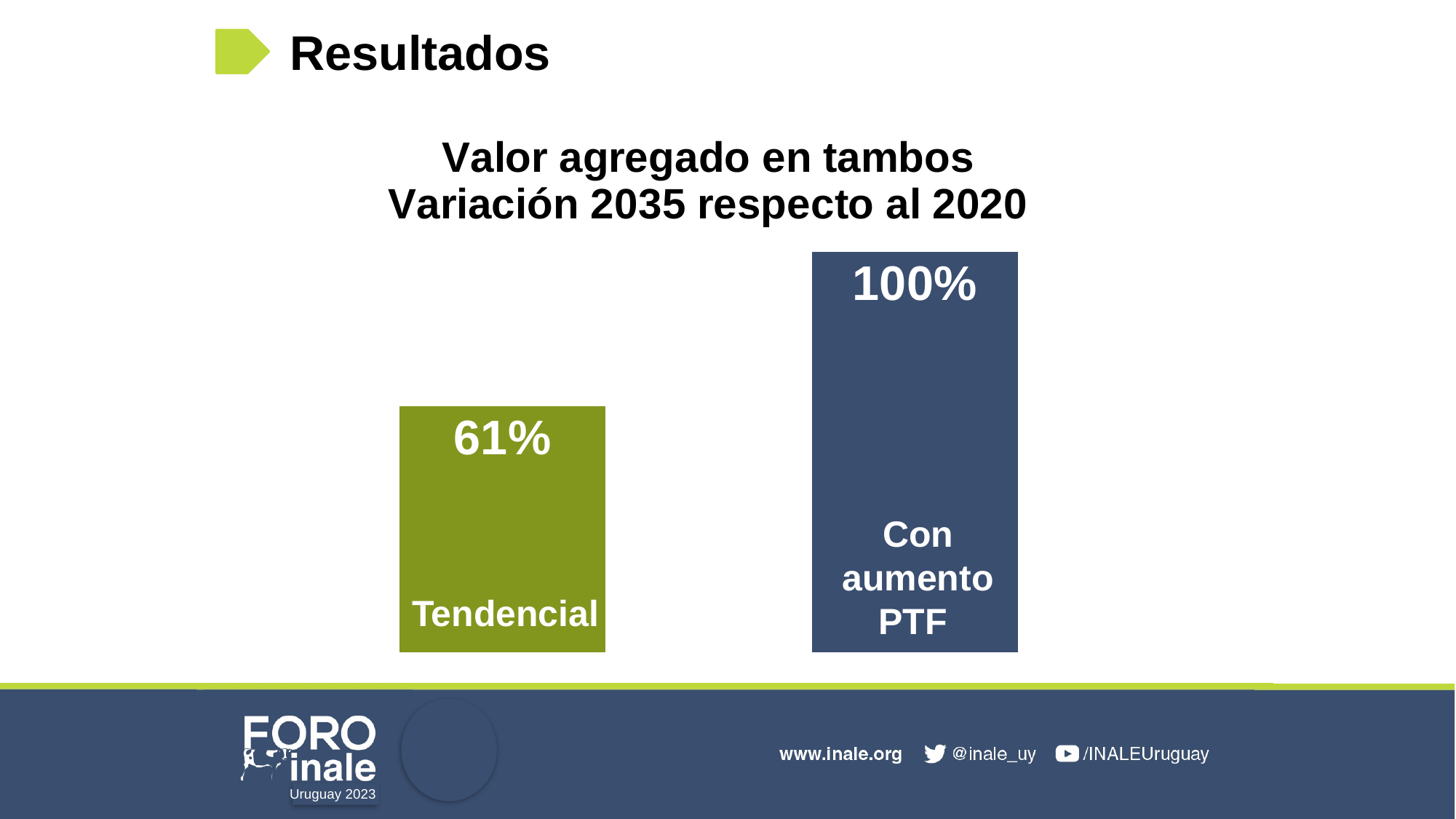
What kind of chart is shown on the slide? Bar chart How many categories are shown in the chart? 2 Which is larger, the value for Tendencial or the value for Con aumento PTF? Con aumento PTF Which category has the highest value? Con aumento PTF What is the difference between the values for Con aumento PTF and Tendencial? 39% What is the value for Tendencial? 61% What is the value for Con aumento PTF? 100% Which category has the lowest value? Tendencial What is the title of the chart? Valor agregado en tambos Variación 2035 respecto al 2020 What colour is the bar for Tendencial? Green